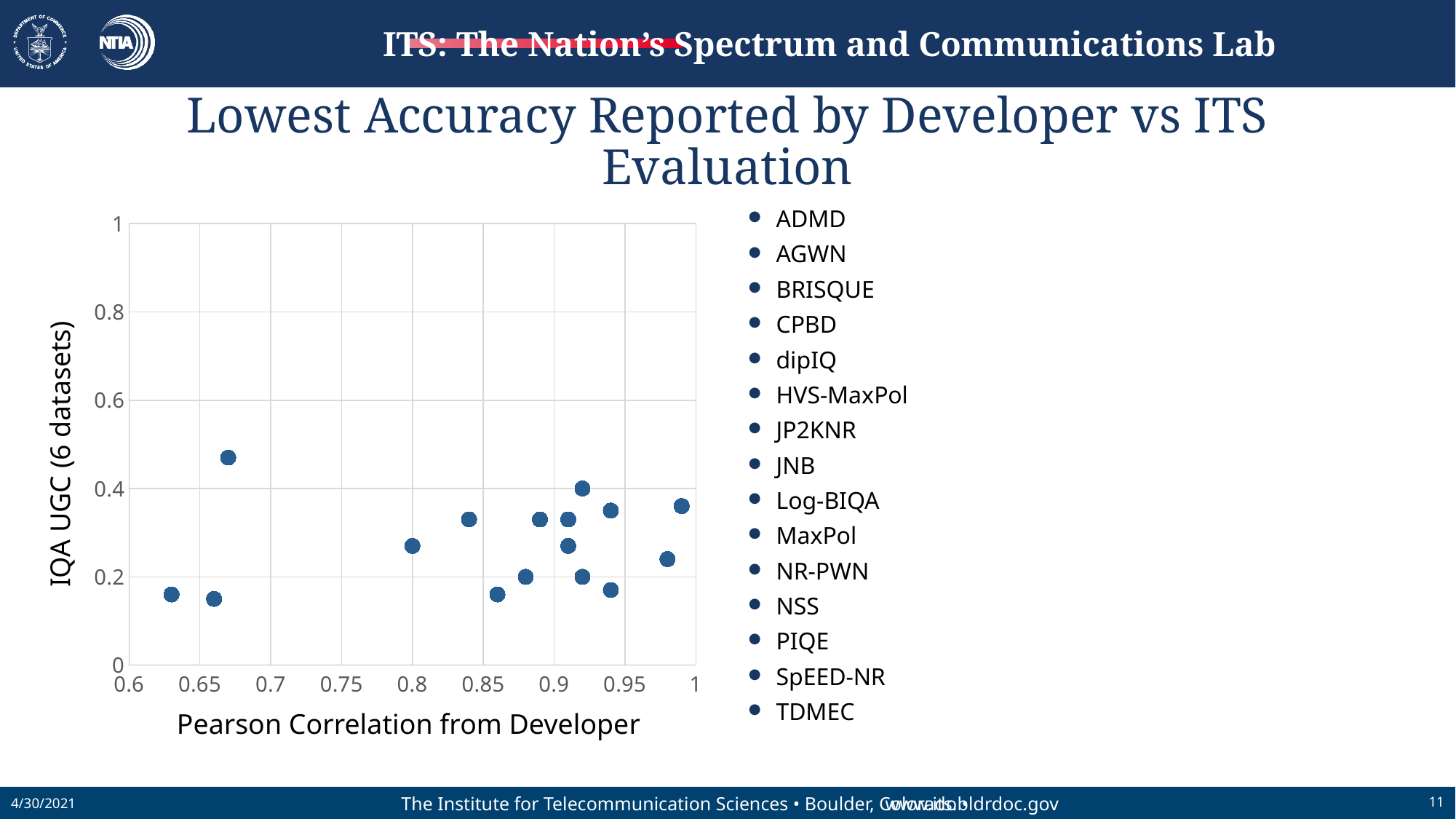
Is the Pearson Correlation of the leftmost point greater or less than 0.65? less What is the label of the x axis? Pearson Correlation from Developer Are all plotted points' Pearson Correlation values greater or less than 0.6? greater Is the highest IQA UGC value plotted greater or less than 0.6? less What is the title of the chart? Lowest Accuracy Reported by Developer vs ITS Evaluation What kind of chart is shown on the slide? scatter chart